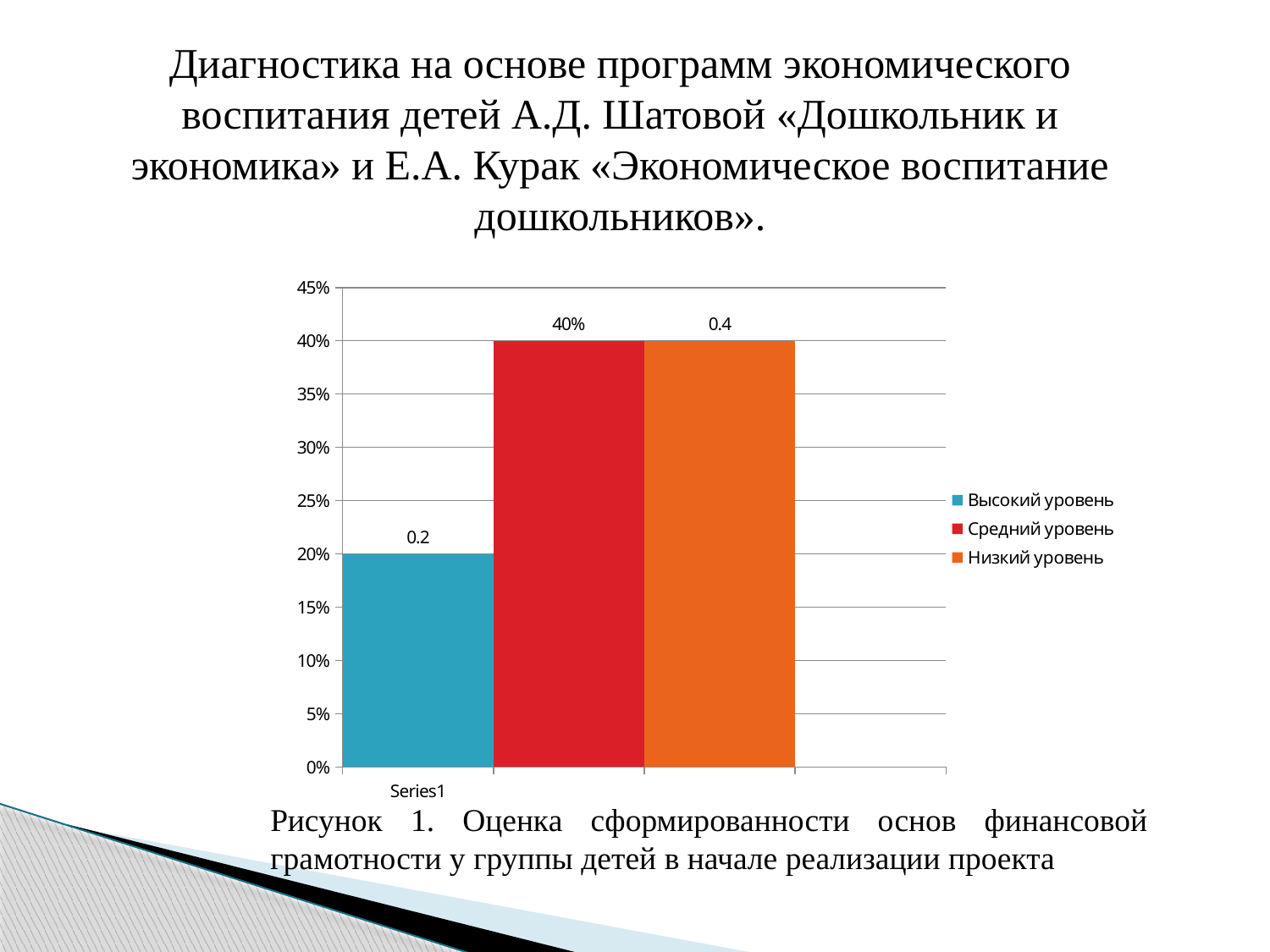
What colour is the bar for Низкий уровень? orange What type of chart is shown on the slide? bar chart Which is larger, the bar for Высокий уровень or the bar for Средний уровень? Средний уровень Which level has the lowest bar in the chart? Высокий уровень What is the label shown on the x axis under the bars? Series1 What value is labelled on the bar for Высокий уровень? 0.2 Is the value for Низкий уровень greater or less than 30%? greater How many series does the legend list? 3 Is the value for Высокий уровень greater or less than 25%? less What is the highest value shown on the vertical axis? 45% What value is labelled on the bar for Низкий уровень? 0.4 What value is labelled on the bar for Средний уровень? 40%